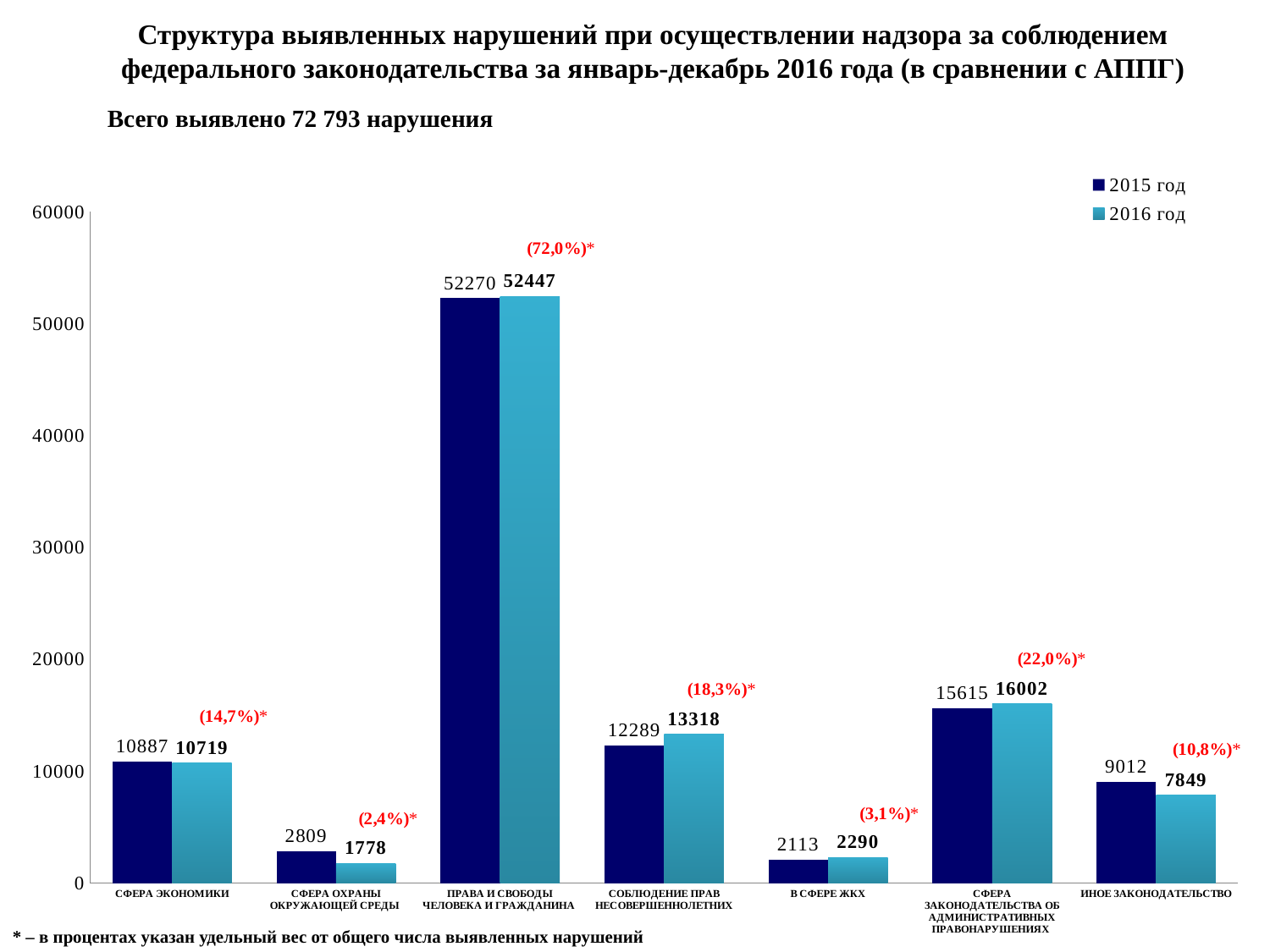
What is the 2015 год value for СОБЛЮДЕНИЕ ПРАВ НЕСОВЕРШЕННОЛЕТНИХ? 12289 What is the difference between the 2016 год and 2015 год values for СФЕРА ЗАКОНОДАТЕЛЬСТВА ОБ АДМИНИСТРАТИВНЫХ ПРАВОНАРУШЕНИЯХ? 387 Which category has the lowest 2016 год value? СФЕРА ОХРАНЫ ОКРУЖАЮЩЕЙ СРЕДЫ What percentage share is shown in red above the bars for ПРАВА И СВОБОДЫ ЧЕЛОВЕКА И ГРАЖДАНИНА? (72,0%)* What kind of chart is shown on the slide? bar chart Which category has the highest 2016 год value? ПРАВА И СВОБОДЫ ЧЕЛОВЕКА И ГРАЖДАНИНА What is the 2016 год value for ИНОЕ ЗАКОНОДАТЕЛЬСТВО? 7849 Is the 2016 год value for В СФЕРЕ ЖКХ greater or less than 10000? less Which is larger for СФЕРА ОХРАНЫ ОКРУЖАЮЩЕЙ СРЕДЫ: the 2015 год value or the 2016 год value? 2015 год How many series does the legend list? 2 How many categories are shown on the x axis? 7 What is the 2016 год value for СФЕРА ЭКОНОМИКИ? 10719